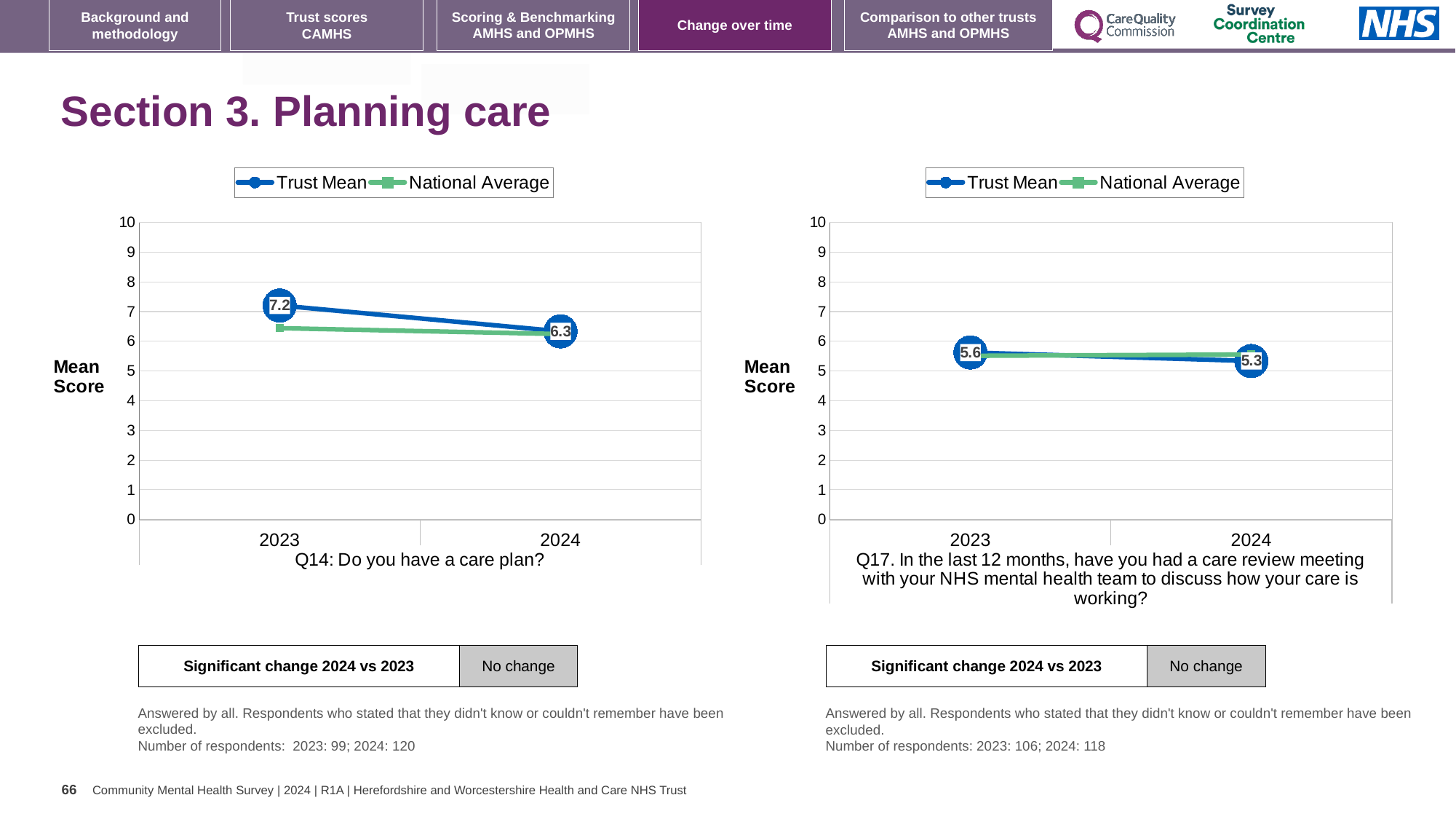
In the Q17 chart (right), what is the Trust Mean score for 2023? 5.6 In the Q14 chart (left), does the Trust Mean rise or fall from 2023 to 2024? fall In the Q14 chart (left), what is the Trust Mean score for 2024? 6.3 In the Q17 chart (right), what is the Trust Mean score for 2024? 5.3 How many series does the legend of the Q14 chart (left) list? 2 What type of chart is used for Q17 (right)? line chart In the Q17 chart (right), is the National Average for 2024 greater or less than 6? less In the Q14 chart (left), what is the Trust Mean score for 2023? 7.2 In the Q14 chart (left), which year has the higher Trust Mean score, 2023 or 2024? 2023 In the Q17 chart (right), what is the difference between the Trust Mean scores for 2023 and 2024? 0.3 In the Q14 chart (left), by how much did the Trust Mean score change from 2023 to 2024? 0.9 In the Q14 chart (left), is the National Average for 2023 greater or less than 6? greater